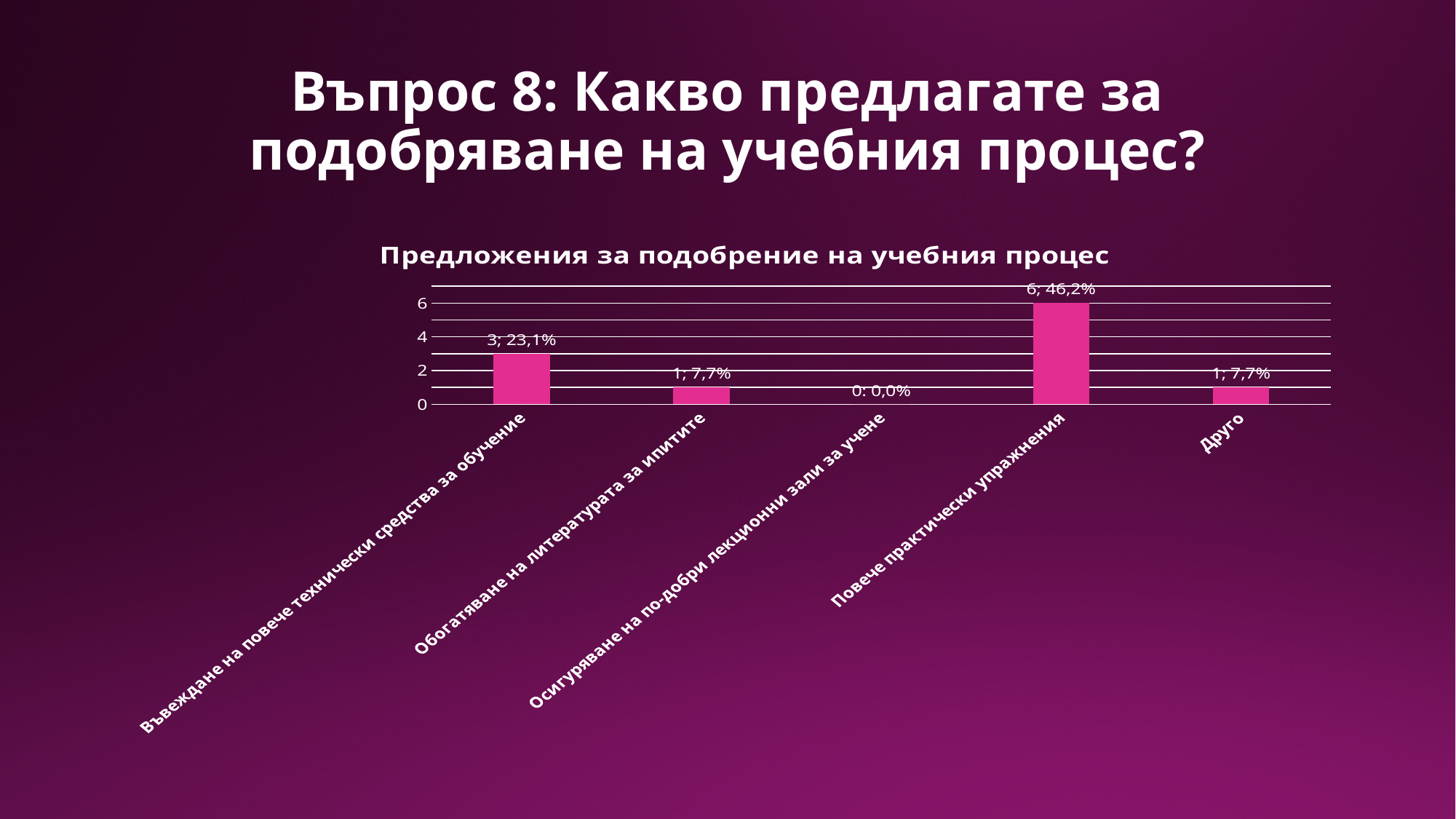
What is the difference in count between "Повече практически упражнения" and "Въвеждане на повече технически средства за обучение"? 3 Which category has the highest value? Повече практически упражнения What is the value shown for "Осигуряване на по-добри лекционни зали за учене"? 0; 0,0% What is the value shown for "Друго"? 1; 7,7% How many categories are shown on the x axis? 5 What is the value shown for "Повече практически упражнения"? 6; 46,2% Which is larger, the value for "Въвеждане на повече технически средства за обучение" or the value for "Обогатяване на литературата за ипитите"? Въвеждане на повече технически средства за обучение What is the value shown for "Въвеждане на повече технически средства за обучение"? 3; 23,1% What is the title of the chart? Предложения за подобрение на учебния процес Is the value for "Повече практически упражнения" greater or less than 4? greater Which category has the lowest value? Осигуряване на по-добри лекционни зали за учене What kind of chart is shown on the slide? bar chart